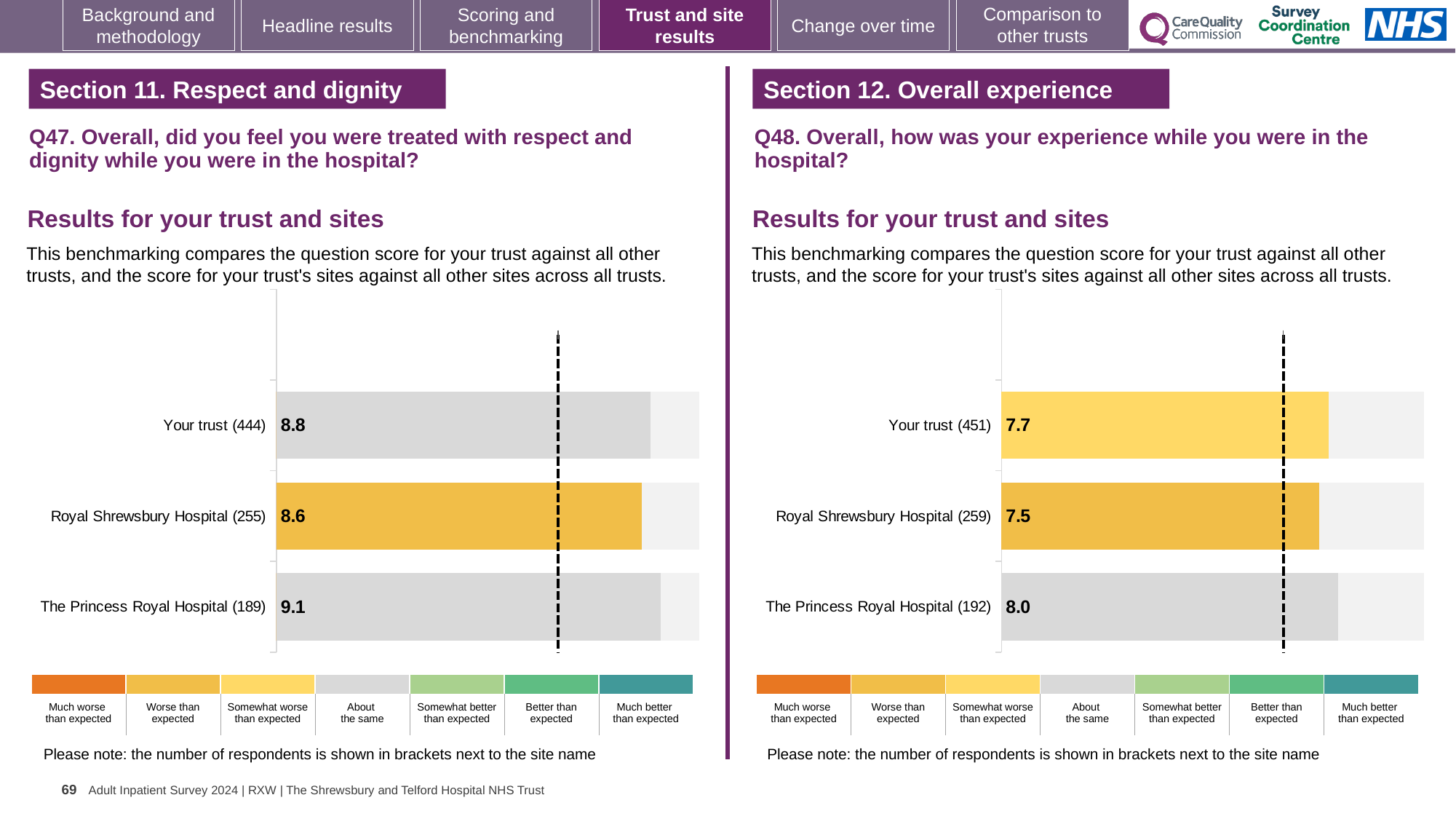
In the Q48 chart on the right, which has the larger score, Your trust or Royal Shrewsbury Hospital? Your trust In the Q47 chart on the left, what is the score for Royal Shrewsbury Hospital? 8.6 In the Q48 chart on the right, how many respondents are shown in brackets for Royal Shrewsbury Hospital? 259 In the Q47 chart on the left, what is the difference between the scores for The Princess Royal Hospital and Royal Shrewsbury Hospital? 0.5 In the Q47 chart on the left, what is the score for Your trust? 8.8 What kind of chart is used for the Q48 results on the right? Bar chart In the Q48 chart on the right, what is the difference between the scores for The Princess Royal Hospital and Your trust? 0.3 In the Q47 chart on the left, which site or trust has the highest score? The Princess Royal Hospital In the Q48 chart on the right, which site or trust has the lowest score? Royal Shrewsbury Hospital In the Q48 chart on the right, what is the score for The Princess Royal Hospital? 8.0 How many bars are plotted in the Q47 chart on the left? 3 In the Q48 chart on the right, what is the score for Your trust? 7.7